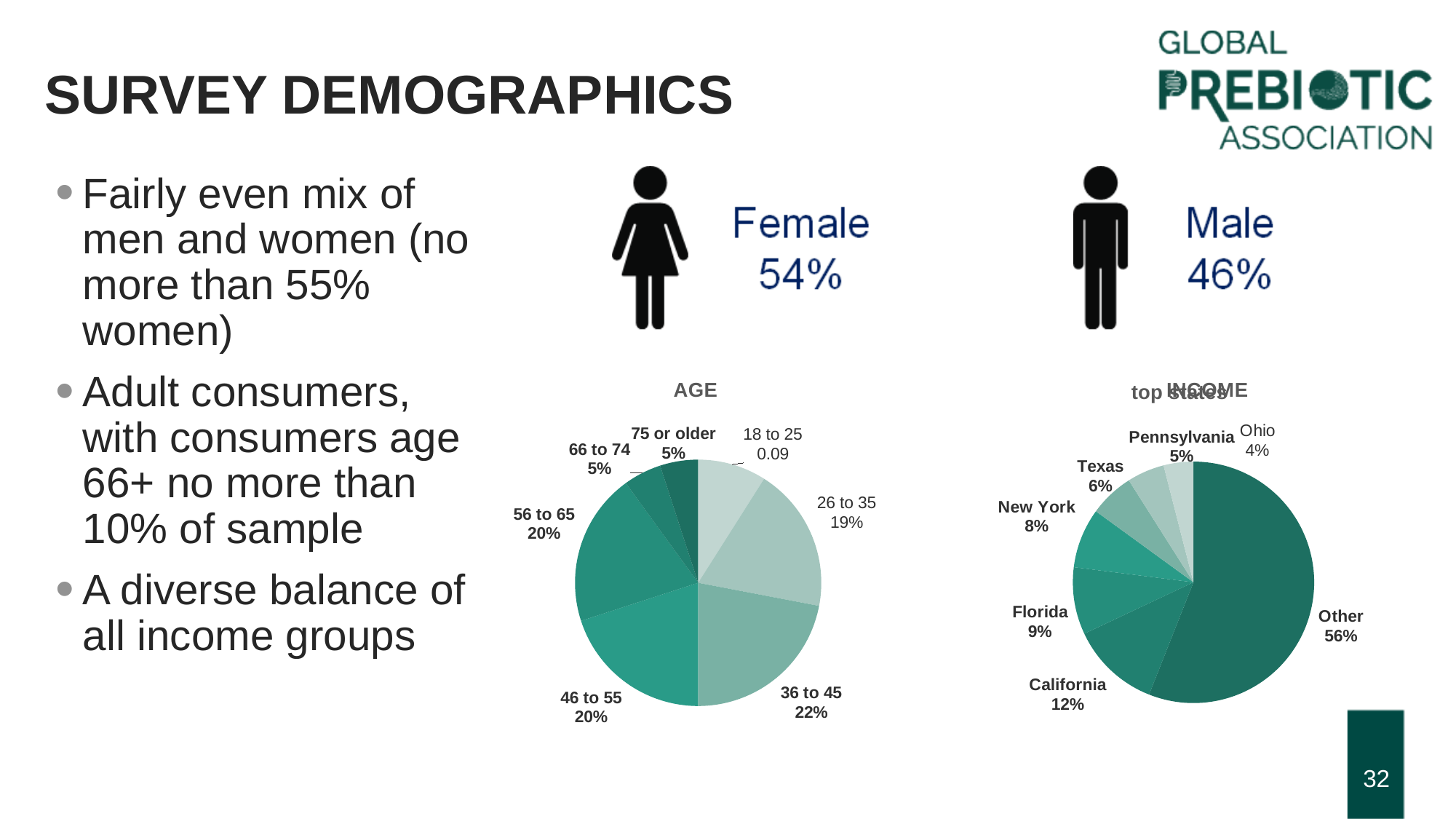
In the AGE pie chart, what is the difference between the shares for 26 to 35 and 66 to 74? 14% In the pie chart on the right, how many slices are shown? 7 In the AGE pie chart, which is larger: the share for 46 to 55 or the share for 75 or older? 46 to 55 In the AGE pie chart, which age group has the largest share? 36 to 45 What type of chart is used for the AGE data? Pie chart In the pie chart on the right, what is the difference between the shares for Florida and Texas? 3% In the pie chart on the right, which slice is the largest? Other In the AGE pie chart, what value is printed for the 18 to 25 group? 0.09 In the AGE pie chart, what share is shown for the 36 to 45 group? 22% In the AGE pie chart, how many age groups are shown? 7 In the pie chart on the right, what share is shown for California? 12% In the pie chart on the right, which state has the smallest share? Ohio